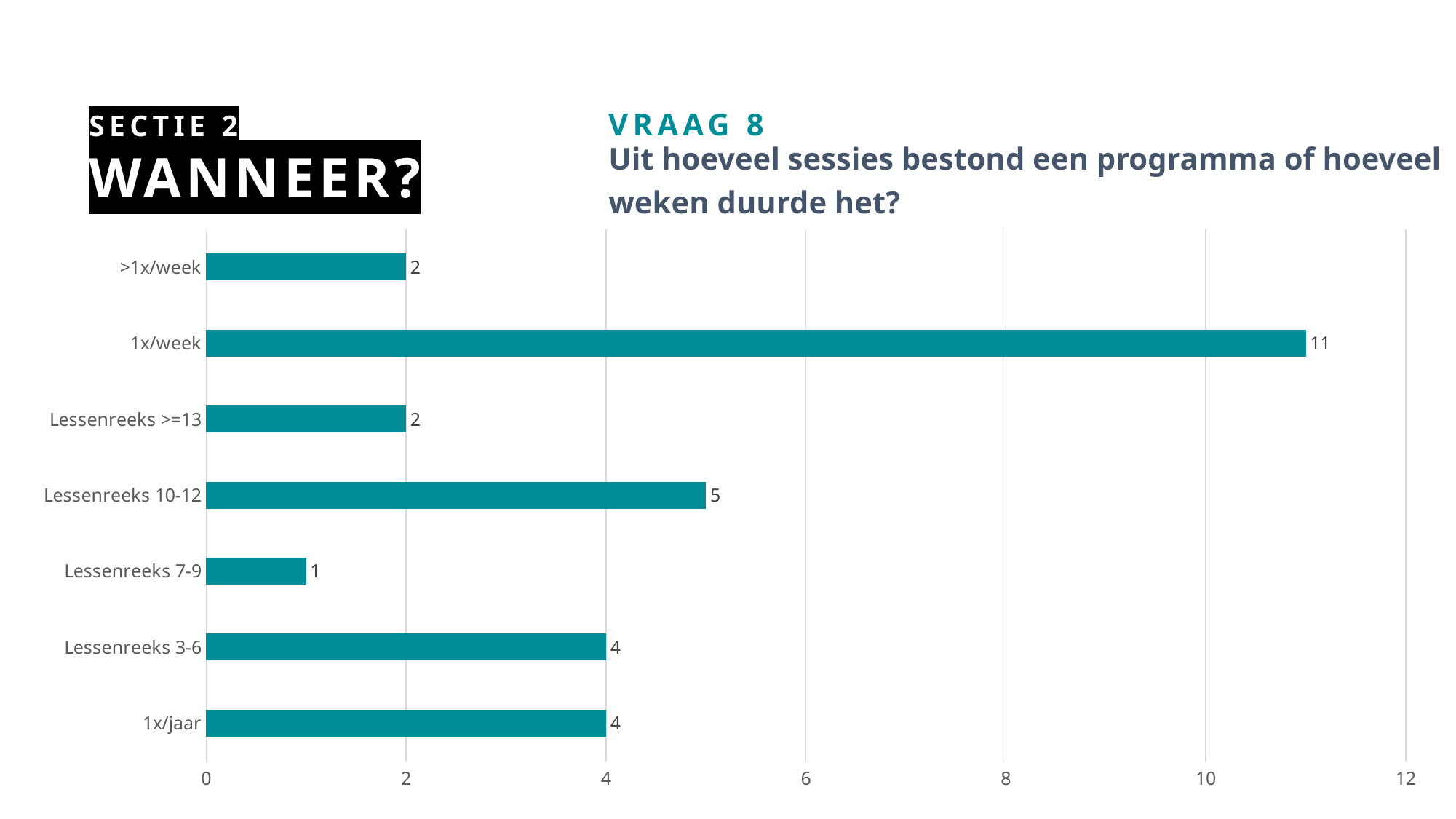
What is the highest value shown on the x axis? 12 What is the value for Lessenreeks 10-12? 5 What is the value for 1x/jaar? 4 Is the value for 1x/week greater or less than 10? greater Which is larger, the value for Lessenreeks 3-6 or the value for Lessenreeks >=13? Lessenreeks 3-6 What is the difference between the values for 1x/week and Lessenreeks 10-12? 6 What kind of chart is shown on the slide? bar chart What is the value for 1x/week? 11 How many categories are shown in the chart? 7 Which category has the highest value? 1x/week Which category has the lowest value? Lessenreeks 7-9 What is the value for Lessenreeks 7-9? 1